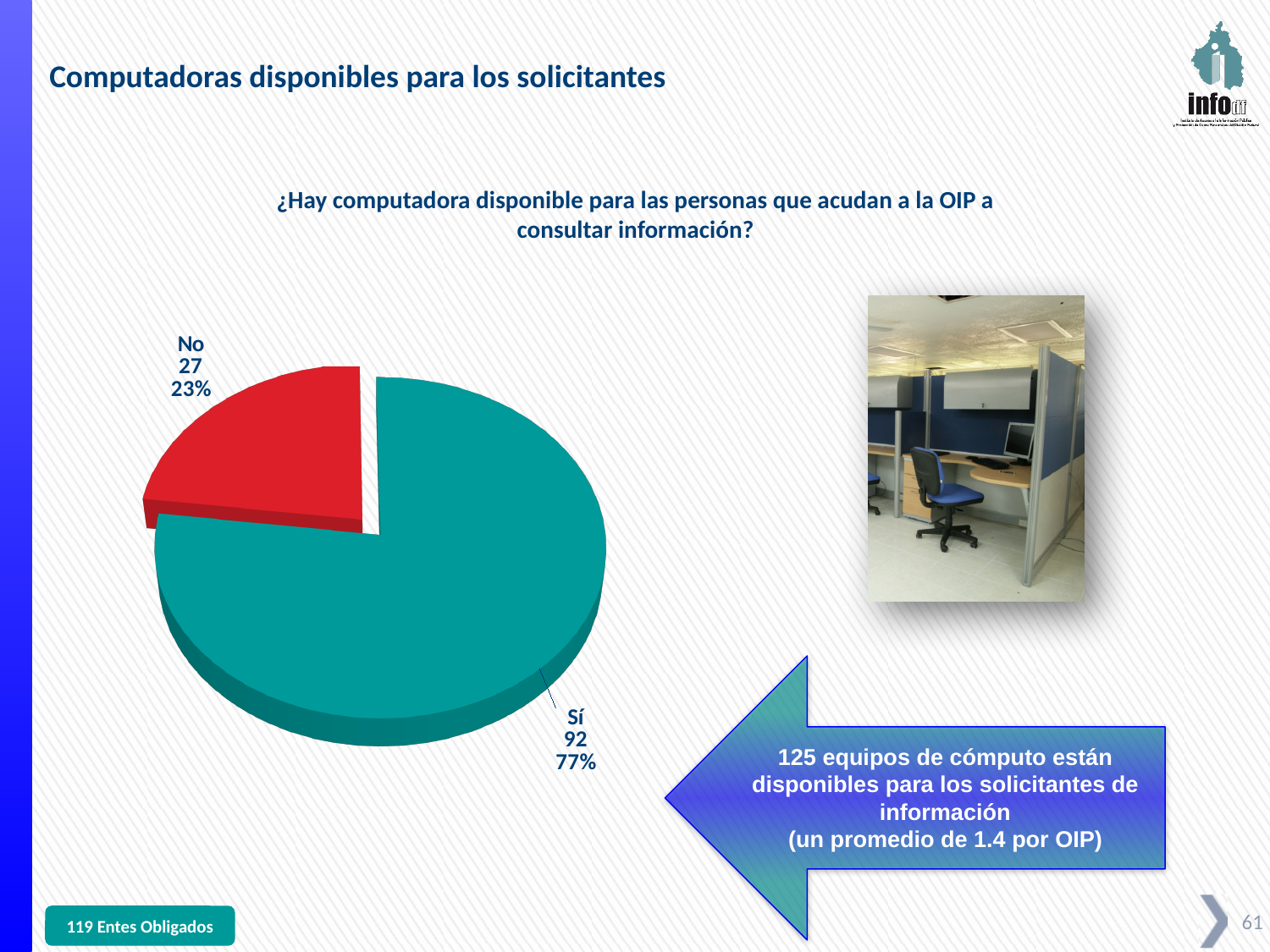
What percentage share does the 'No' slice represent? 23% Which slice is the smallest? No How many slices does the pie chart have? 2 Which slice is the largest? Sí What is the count for the 'Sí' slice? 92 What percentage share does the 'Sí' slice represent? 77% Which is larger, the 'Sí' slice or the 'No' slice? Sí What is the total of the two slice counts? 119 What is the difference between the 'Sí' count and the 'No' count? 65 What kind of chart is shown on the slide? pie chart What is the count for the 'No' slice? 27 What colour is the 'No' slice? red